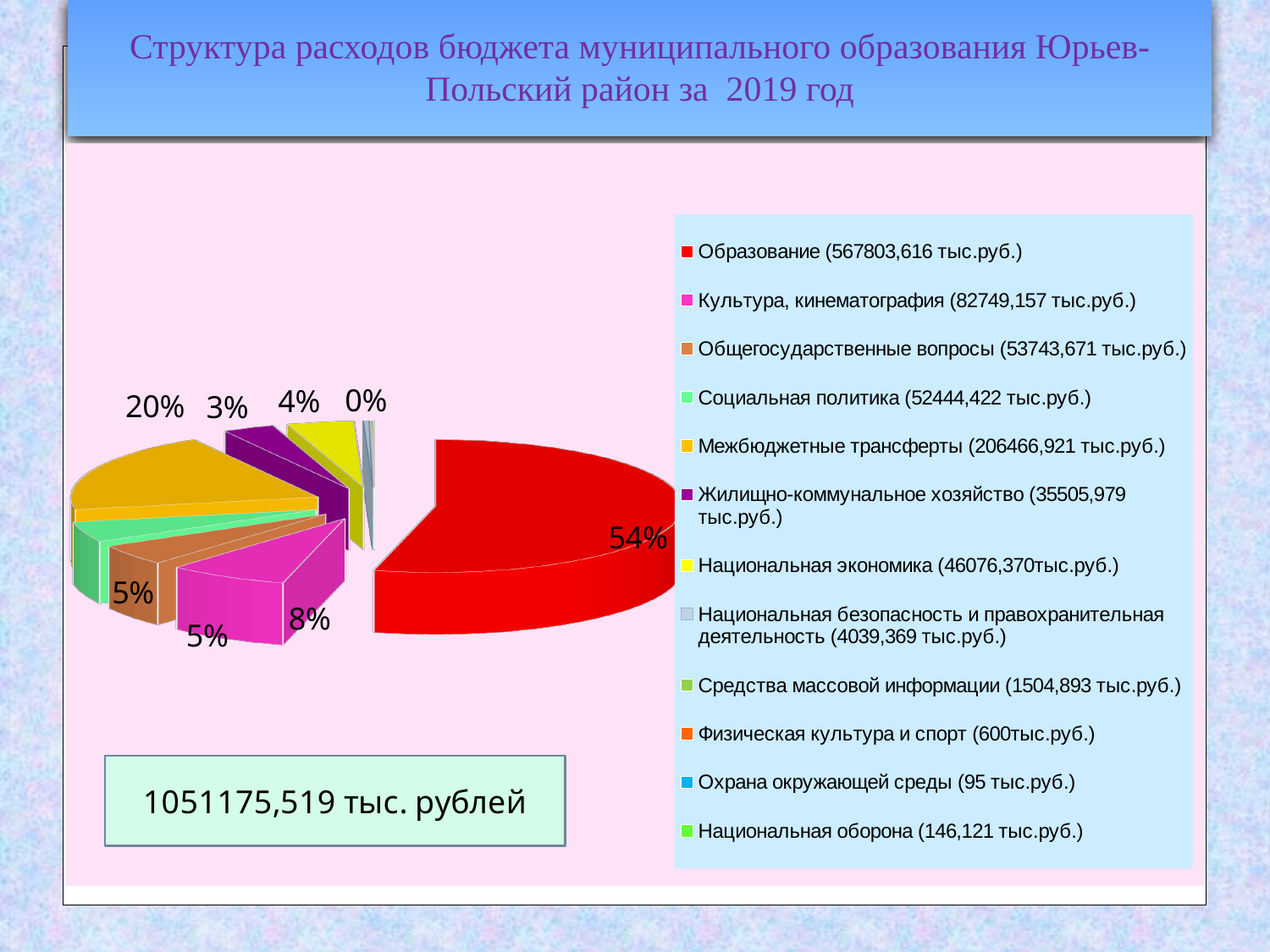
According to the legend, what is the amount for Культура, кинематография? 82749,157 тыс.руб. Which category in the legend has the smallest amount? Охрана окружающей среды Which category has the largest share of the pie? Образование By how many percentage points does the share for Образование exceed the share for Межбюджетные трансферты? 34 What share of the pie does Межбюджетные трансферты account for? 20% What share of the pie does Культура, кинематография account for? 8% How many categories does the legend list? 12 What kind of chart is shown on the slide? pie chart According to the legend, what is the amount for Образование? 567803,616 тыс.руб. According to the legend, what is the amount for Национальная оборона? 146,121 тыс.руб. Which is larger, the share for Межбюджетные трансферты or the share for Культура, кинематография? Межбюджетные трансферты What share of the pie does Образование account for? 54%